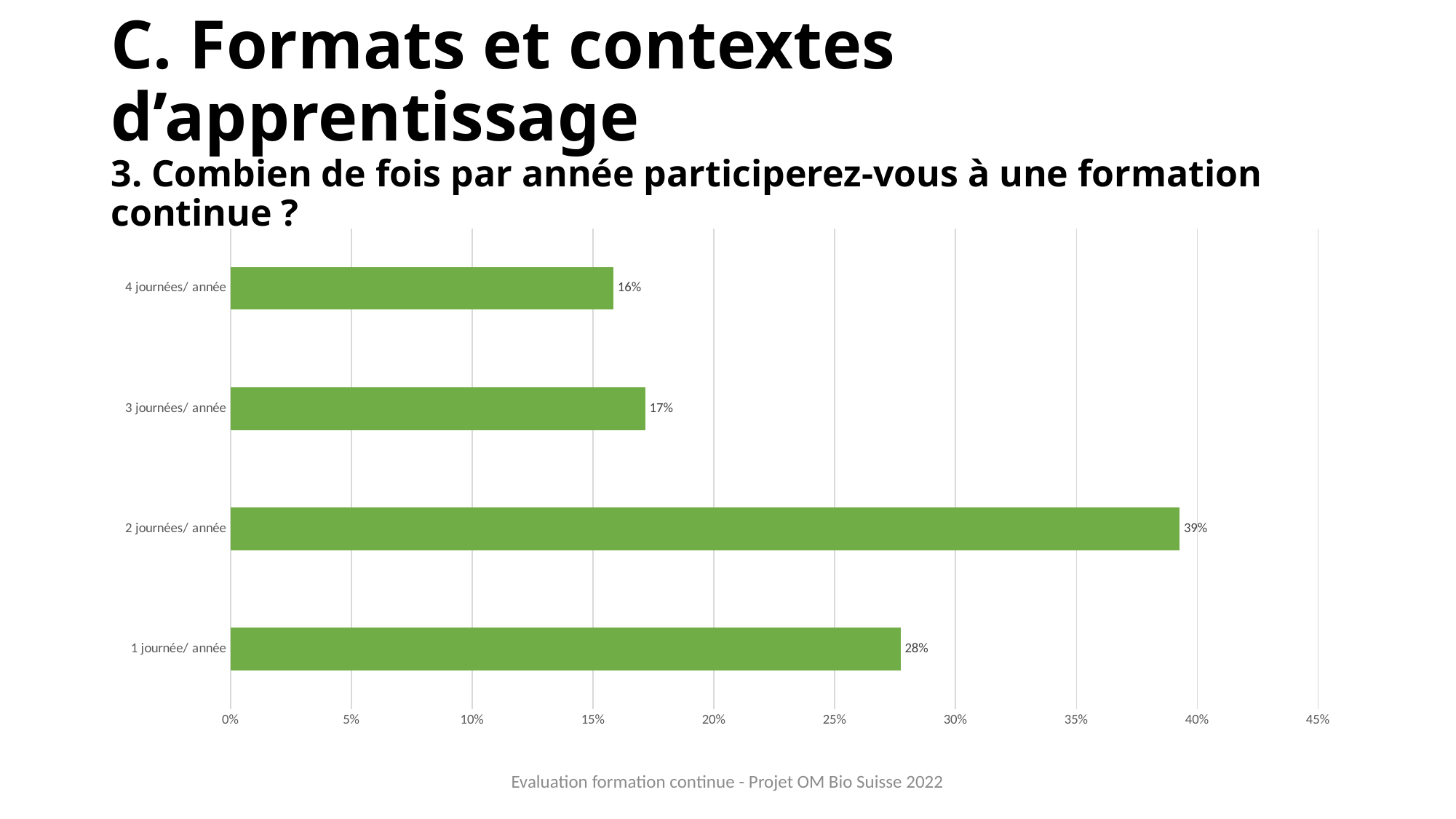
What is the value for "4 journées/ année"? 16% Which category has the lowest value? 4 journées/ année What is the text shown below the chart? Evaluation formation continue - Projet OM Bio Suisse 2022 What is the difference between the values for "2 journées/ année" and "1 journée/ année"? 11% How many categories are shown in the chart? 4 What kind of chart is shown on the slide? Bar chart Which is larger, the value for "1 journée/ année" or "3 journées/ année"? 1 journée/ année Is the value for "2 journées/ année" greater or less than 35%? greater What is the value for "2 journées/ année"? 39% What is the value for "1 journée/ année"? 28% What is the value for "3 journées/ année"? 17% Which category has the highest value? 2 journées/ année